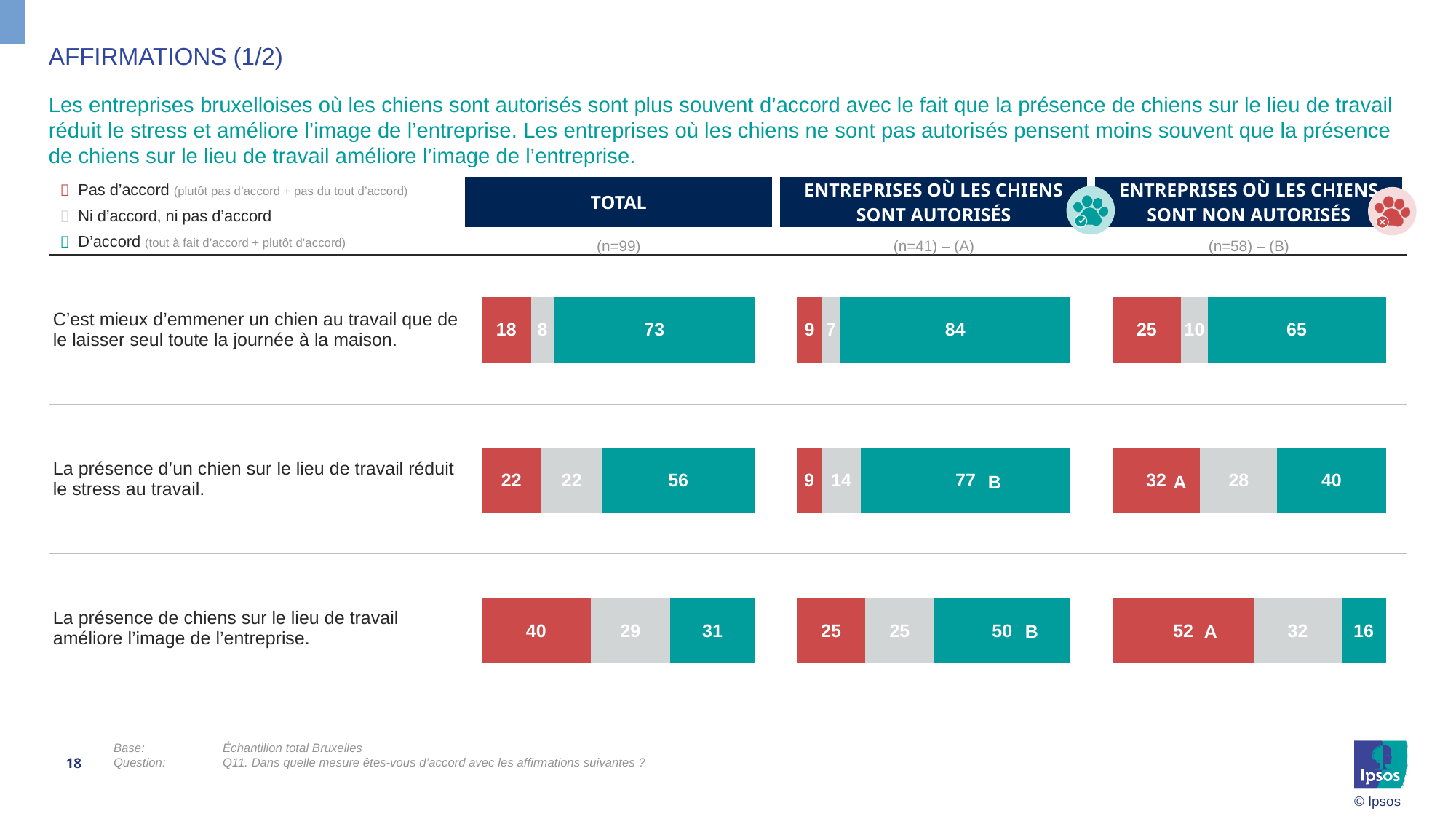
What kind of chart is used to show the results in the TOTAL column? Stacked bar chart What is the sample size (n) shown for the ENTREPRISES OÙ LES CHIENS SONT AUTORISÉS chart? n=41 How many statements are shown in the TOTAL chart? 3 What is the difference between the 'D'accord' value for 'La présence d'un chien sur le lieu de travail réduit le stress au travail' in the ENTREPRISES OÙ LES CHIENS SONT AUTORISÉS chart and in the ENTREPRISES OÙ LES CHIENS SONT NON AUTORISÉS chart? 37 In the ENTREPRISES OÙ LES CHIENS SONT NON AUTORISÉS chart, which statement has the lowest 'D'accord' value? La présence de chiens sur le lieu de travail améliore l'image de l'entreprise. How many series does the legend list? 3 In the TOTAL chart, what is the 'D'accord' value for the statement 'C'est mieux d'emmener un chien au travail que de le laisser seul toute la journée à la maison'? 73 In the ENTREPRISES OÙ LES CHIENS SONT NON AUTORISÉS chart, what is the 'Ni d'accord, ni pas d'accord' value for 'La présence d'un chien sur le lieu de travail réduit le stress au travail'? 28 In the TOTAL chart, what is the total of the stacked bar for 'La présence d'un chien sur le lieu de travail réduit le stress au travail'? 100 For 'La présence de chiens sur le lieu de travail améliore l'image de l'entreprise', is the 'Pas d'accord' value larger in the ENTREPRISES OÙ LES CHIENS SONT AUTORISÉS chart or in the ENTREPRISES OÙ LES CHIENS SONT NON AUTORISÉS chart? ENTREPRISES OÙ LES CHIENS SONT NON AUTORISÉS In the ENTREPRISES OÙ LES CHIENS SONT AUTORISÉS chart, what is the 'Pas d'accord' value for 'La présence de chiens sur le lieu de travail améliore l'image de l'entreprise'? 25 In the TOTAL chart, which statement has the highest 'Pas d'accord' value? La présence de chiens sur le lieu de travail améliore l'image de l'entreprise.